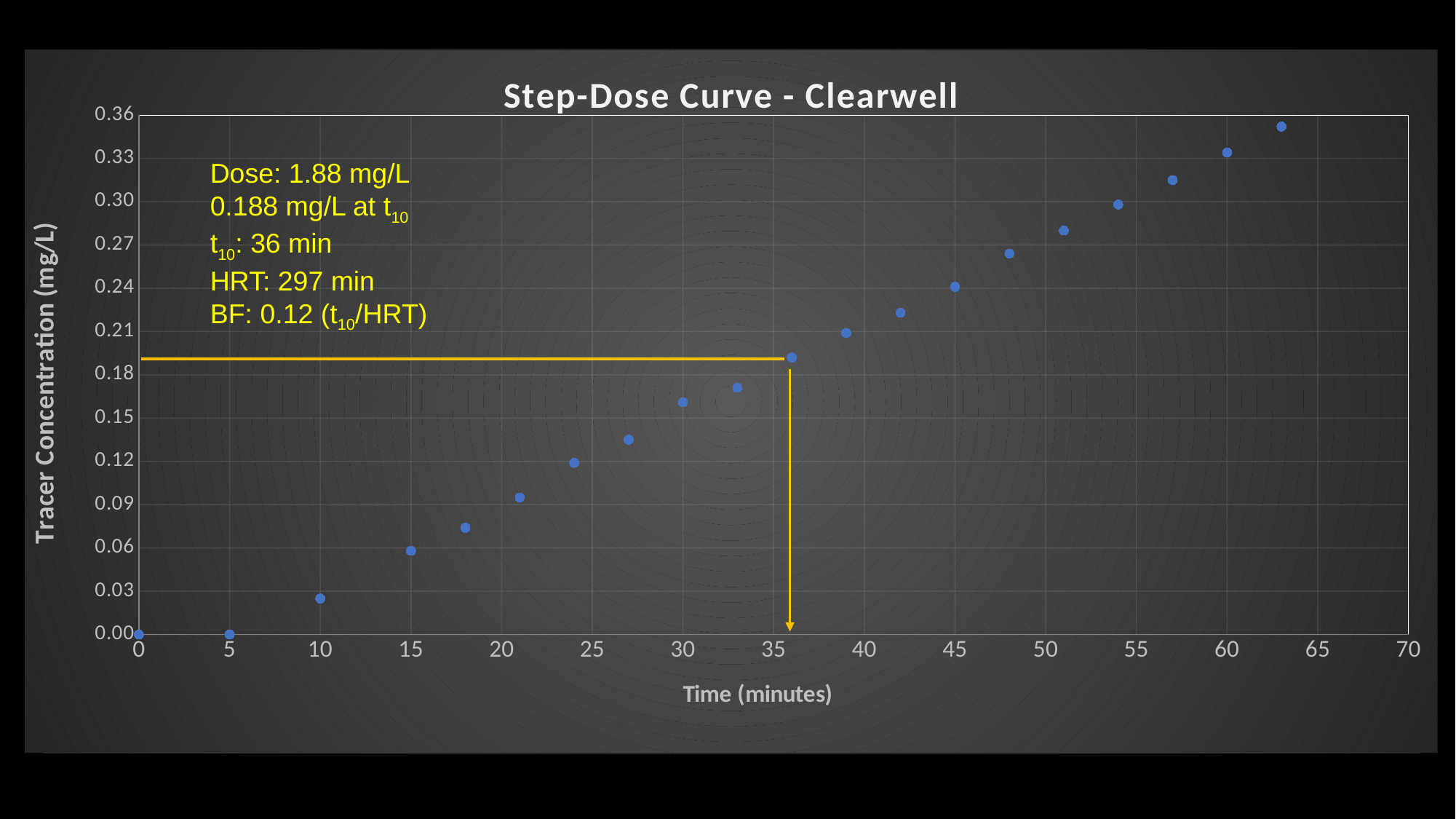
According to the annotation, what is the tracer concentration at t10 (36 min)? 0.188 mg/L What is the tracer concentration at 0 minutes? 0.00 Is the tracer concentration at 30 minutes greater or less than 0.15? greater How many data points are plotted on the chart? 20 What is the title of the chart? Step-Dose Curve - Clearwell Do the tracer concentration values rise or fall as time increases? rise At which time is the tracer concentration highest? 63 Which has the larger tracer concentration, 60 minutes or 30 minutes? 60 minutes Is the tracer concentration at 45 minutes greater or less than 0.21? greater What is the label of the y axis? Tracer Concentration (mg/L) Is the tracer concentration at 60 minutes greater or less than 0.30? greater What kind of chart is shown on the slide? scatter chart